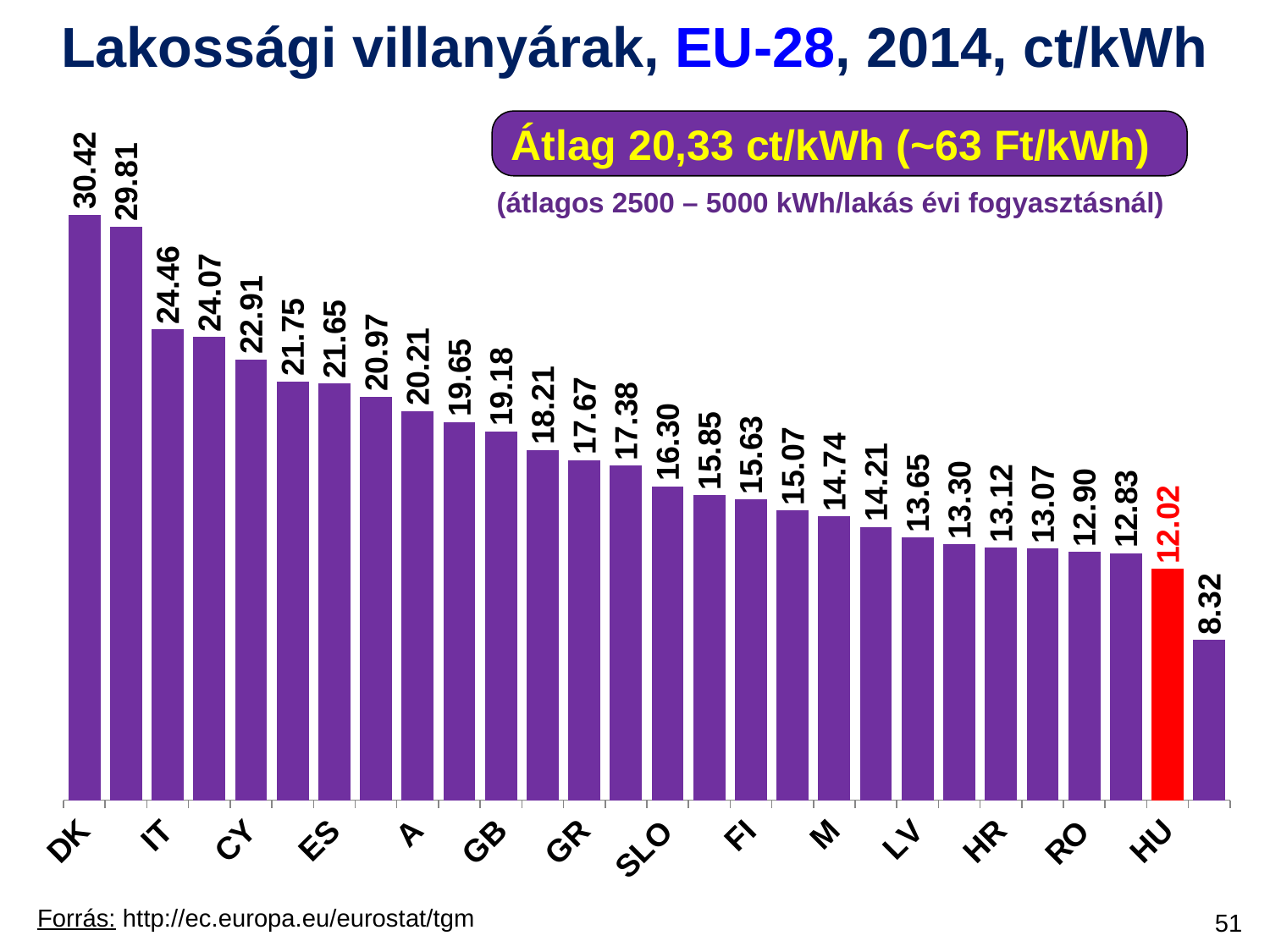
What average value (Átlag) is stated in the box on the slide? 20,33 ct/kWh Do the values rise or fall from left to right along the x axis? fall What is the value for DK? 30.42 What kind of chart is shown on the slide? bar chart Which country has the highest residential electricity price on the chart? DK Which country's bar is highlighted in red? HU How many bars are plotted on the chart? 28 What is the lowest value shown on the chart? 8.32 What is the value of the red bar (HU)? 12.02 Which is larger, the value for DK or the value for HU? DK What is the value for IT? 24.46 What is the difference between the values for DK and HU? 18.40